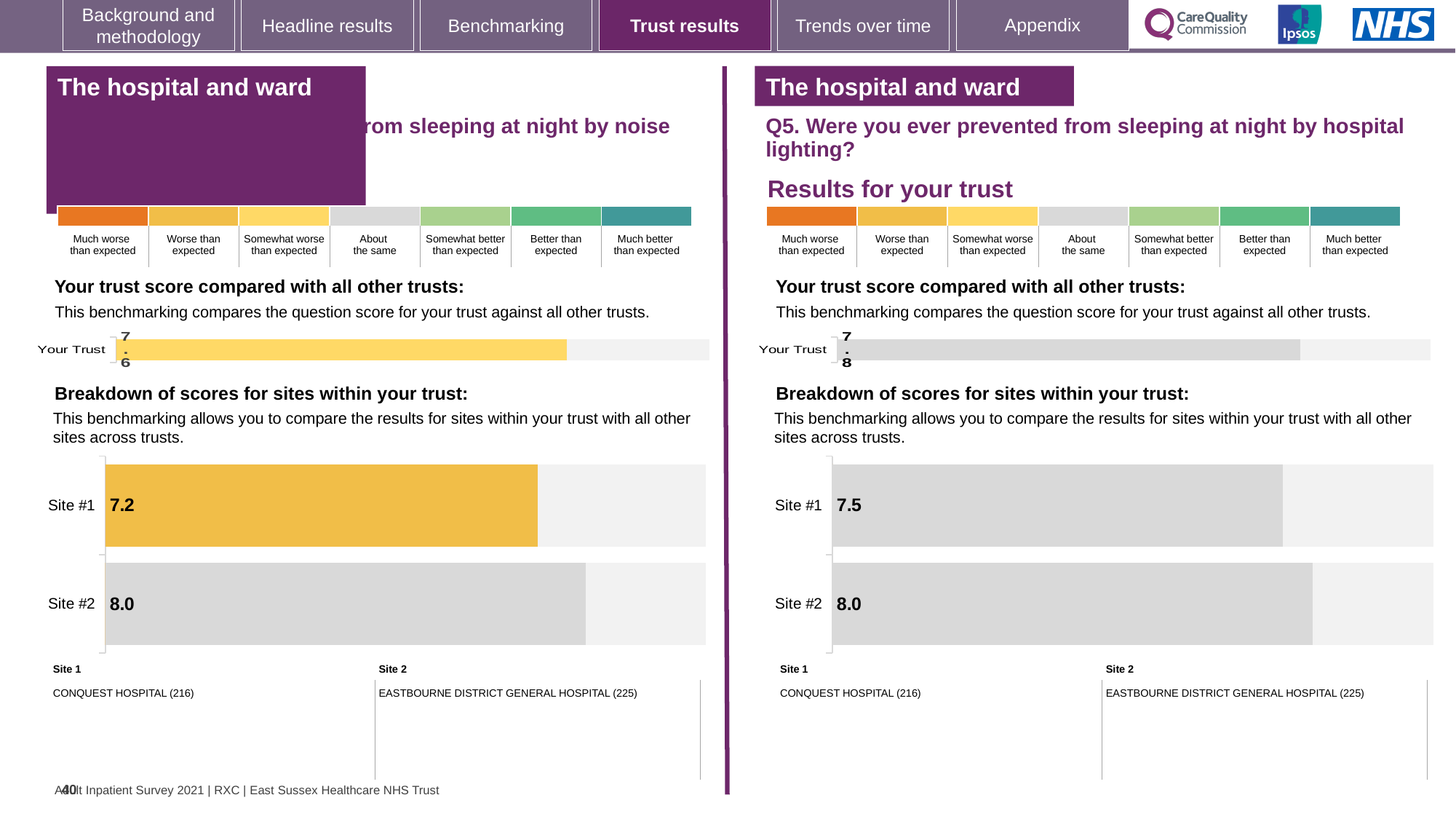
On the left half of the slide (sleeping at night by noise), what is the 'Your Trust' score shown in the trust score chart? 7.6 On the right half of the slide (Q5, hospital lighting), what is the score shown for Site #1 in the breakdown of scores for sites chart? 7.5 On the right half of the slide (Q5, hospital lighting), what is the 'Your Trust' score shown in the trust score chart? 7.8 On the left half of the slide (sleeping at night by noise), what is the score shown for Site #2 in the breakdown of scores for sites chart? 8.0 In the right breakdown of scores for sites chart (Q5, hospital lighting), which site has the lower score? Site #1 In the left breakdown of scores for sites chart (sleeping at night by noise), which site has the higher score? Site #2 In the left breakdown of scores for sites chart (sleeping at night by noise), what is the difference between the Site #2 and Site #1 scores? 0.8 On the right half of the slide (Q5, hospital lighting), what is the score shown for Site #2 in the breakdown of scores for sites chart? 8.0 In the right breakdown of scores for sites chart (Q5, hospital lighting), what is the difference between the Site #2 and Site #1 scores? 0.5 What type of chart is used for the breakdown of scores for sites on the right half of the slide (Q5, hospital lighting)? Bar chart How many sites are shown in the left breakdown of scores for sites chart (sleeping at night by noise)? 2 On the left half of the slide (sleeping at night by noise), what is the score shown for Site #1 in the breakdown of scores for sites chart? 7.2